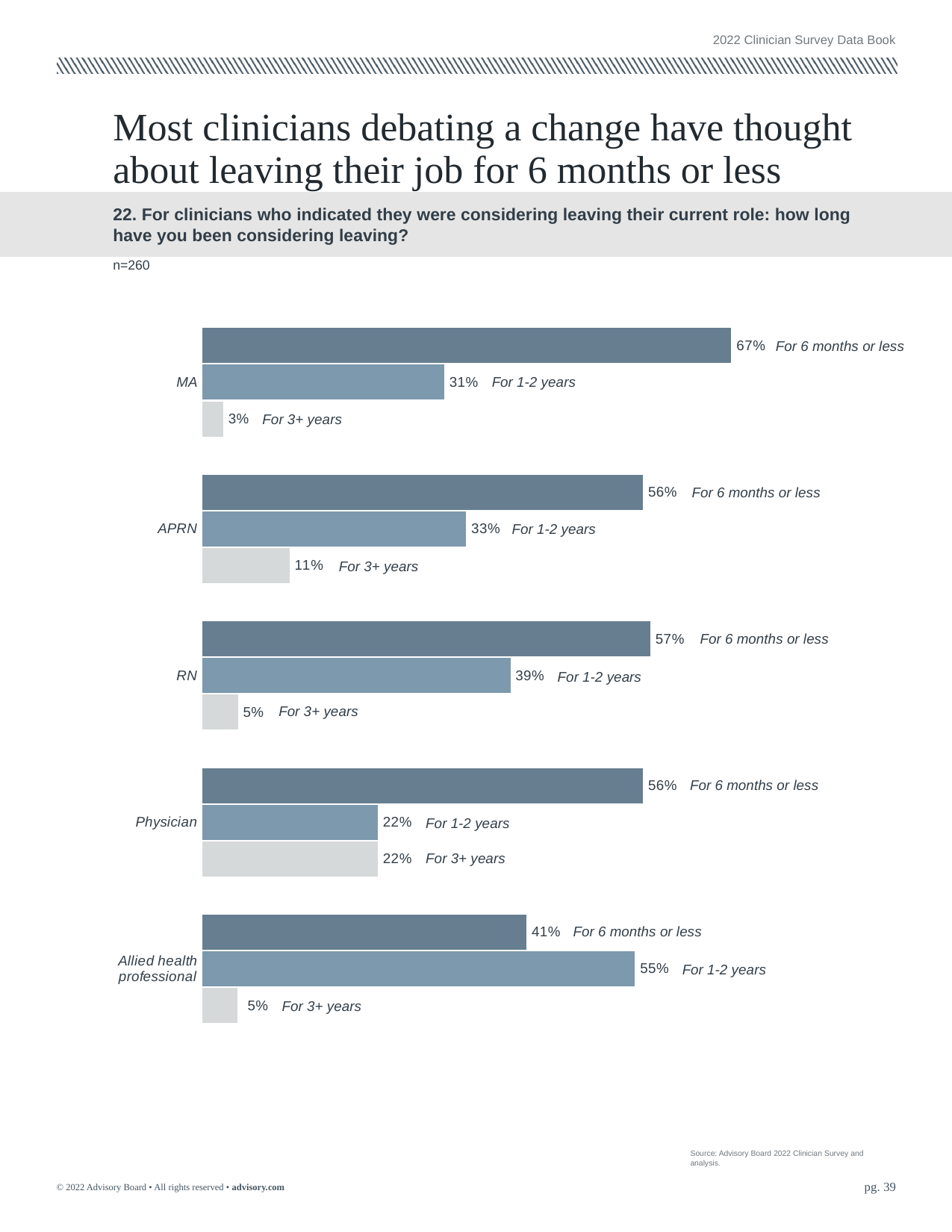
What percentage of allied health professionals have been considering leaving for 1-2 years? 55% What is the sample size (n) shown for the chart? n=260 What percentage of APRNs have been considering leaving for 3+ years? 11% What kind of chart is shown on the slide? Bar chart What is the difference between the MA and Physician shares for 'For 6 months or less'? 11% Which clinician group has the highest share considering leaving for 6 months or less? MA For physicians, which is larger: the share considering leaving for 6 months or less, or the share for 1-2 years? For 6 months or less What percentage of MAs have been considering leaving for 6 months or less? 67% What percentage of RNs have been considering leaving for 1-2 years? 39% How many clinician groups are shown in the chart? 5 Which clinician group has the lowest share considering leaving for 6 months or less? Allied health professional How many time-period categories are shown for each clinician group? 3